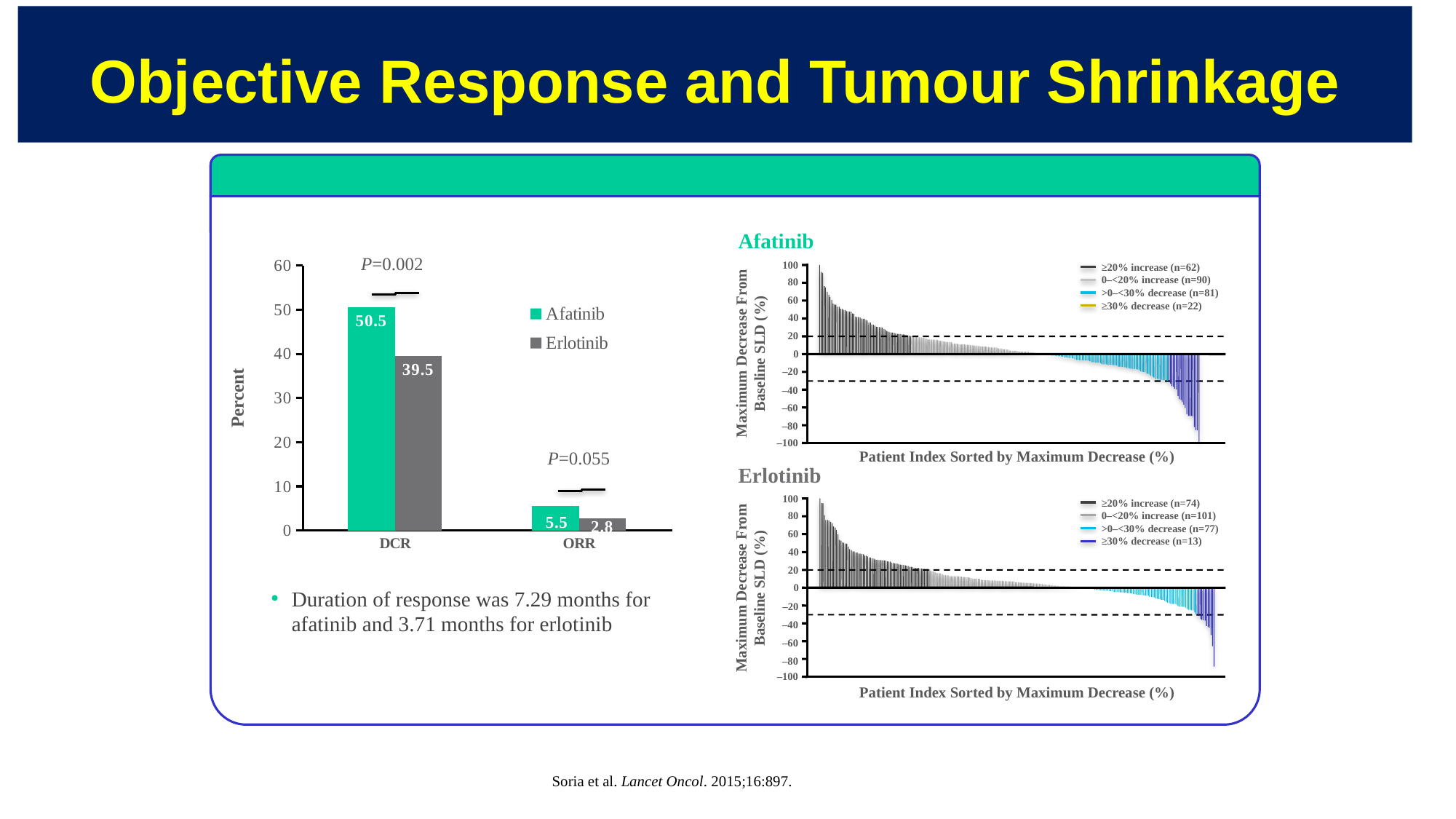
In the Erlotinib waterfall chart on the right, how many patients are in the 0–<20% increase group according to the legend? n=101 What kind of chart is the chart on the left showing DCR and ORR? Bar chart In the bar chart on the left, what is the ORR value for Erlotinib? 2.8 In the bar chart on the left, is the DCR value for Erlotinib greater or less than 40? less In the bar chart on the left, what is the difference between the DCR values for Afatinib and Erlotinib? 11.0 In the bar chart on the left, what P value is shown above the DCR bars? P=0.002 In the bar chart on the left, how many categories are shown on the x axis? 2 In the bar chart on the left, which treatment has the higher ORR, Afatinib or Erlotinib? Afatinib In the Erlotinib waterfall chart on the right, what is the label of the y axis? Maximum Decrease From Baseline SLD (%) In the bar chart on the left, how many series does the legend list? 2 In the Afatinib waterfall chart on the right, how many patients are in the ≥30% decrease group according to the legend? n=22 In the bar chart on the left, what is the DCR value for Afatinib? 50.5